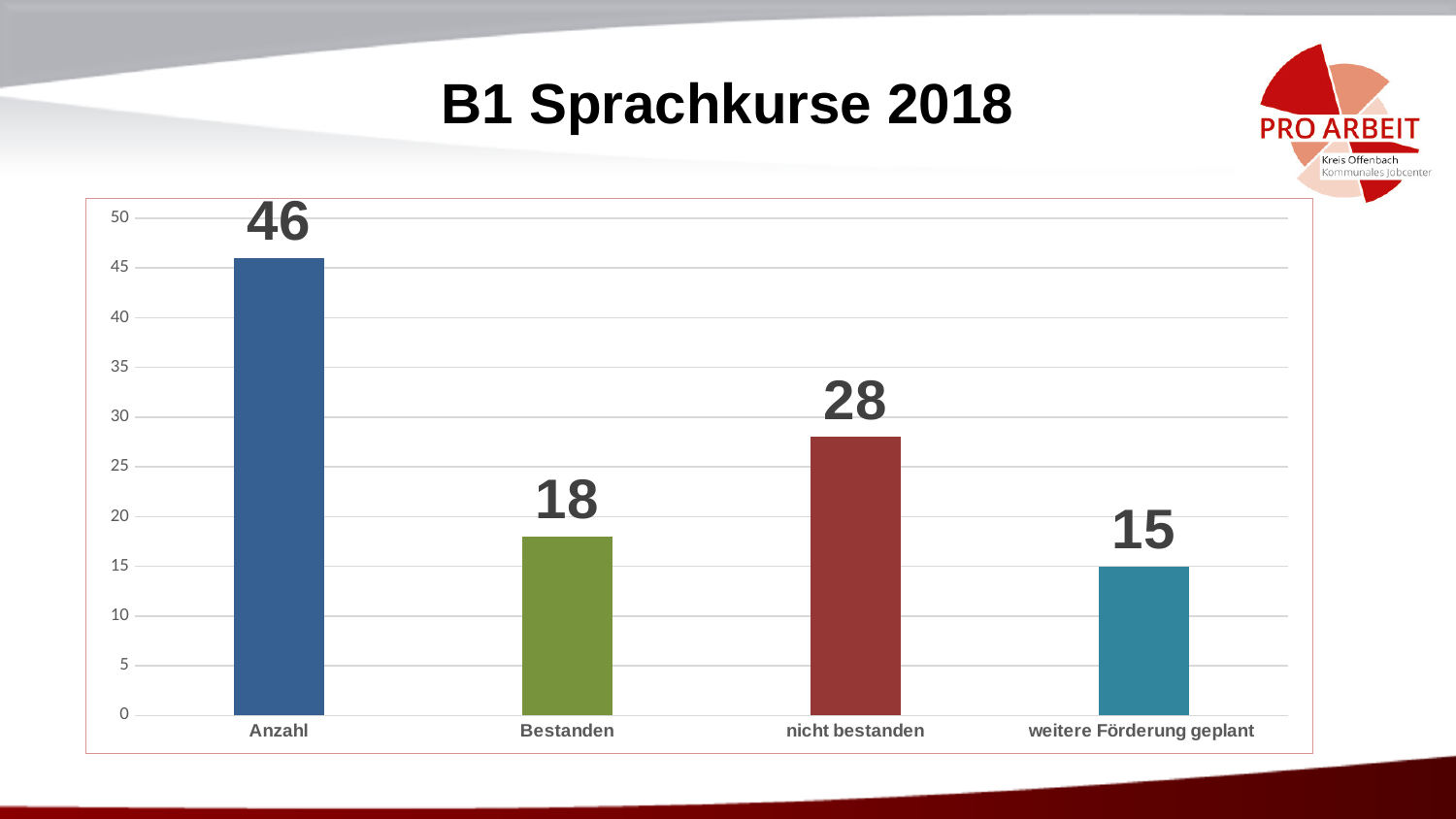
Which is larger, the value for Bestanden or the value for nicht bestanden? nicht bestanden What is the value for Anzahl? 46 How many categories are shown on the x axis? 4 What is the difference between the values for Anzahl and weitere Förderung geplant? 31 Which category has the lowest value? weitere Förderung geplant What is the title of the slide containing the chart? B1 Sprachkurse 2018 What is the difference between the values for nicht bestanden and Bestanden? 10 What is the value for nicht bestanden? 28 What is the value for weitere Förderung geplant? 15 What is the value for Bestanden? 18 Which category has the highest value? Anzahl What kind of chart is shown on the slide? bar chart